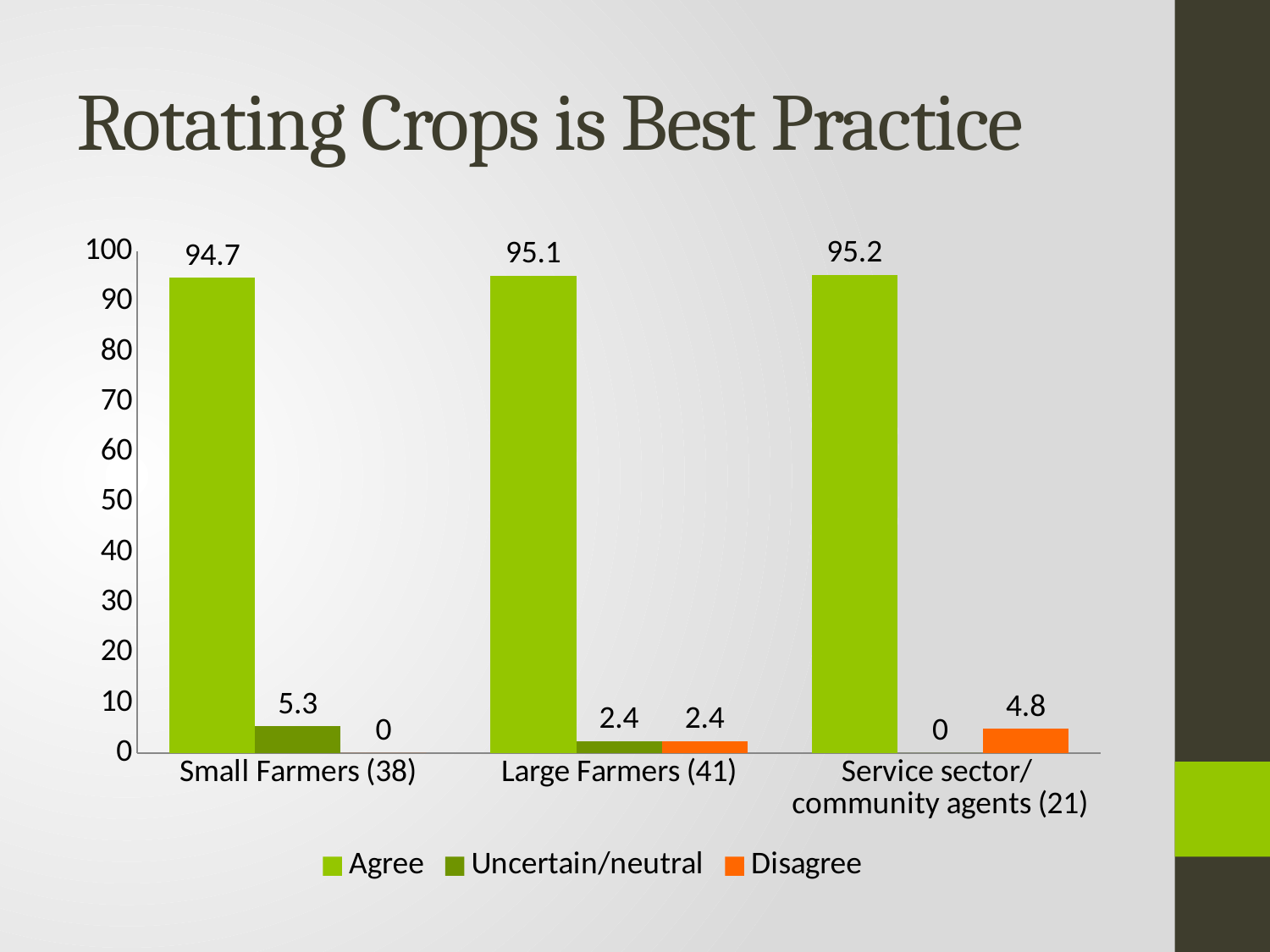
Which category has the lowest Uncertain/neutral value? Service sector/community agents (21) How many categories are shown on the x axis? 3 What is the Uncertain/neutral value for Large Farmers (41)? 2.4 What is the Disagree value for Service sector/community agents (21)? 4.8 What is the Agree value for Small Farmers (38)? 94.7 What is the title of the chart? Rotating Crops is Best Practice How many series does the legend list? 3 What kind of chart is shown on the slide? Bar chart Which category has the highest Agree value? Service sector/community agents (21) What is the difference between the Uncertain/neutral values for Small Farmers (38) and Large Farmers (41)? 2.9 What is the Disagree value for Small Farmers (38)? 0 Which is larger: the Disagree value for Large Farmers (41) or for Service sector/community agents (21)? Service sector/community agents (21)